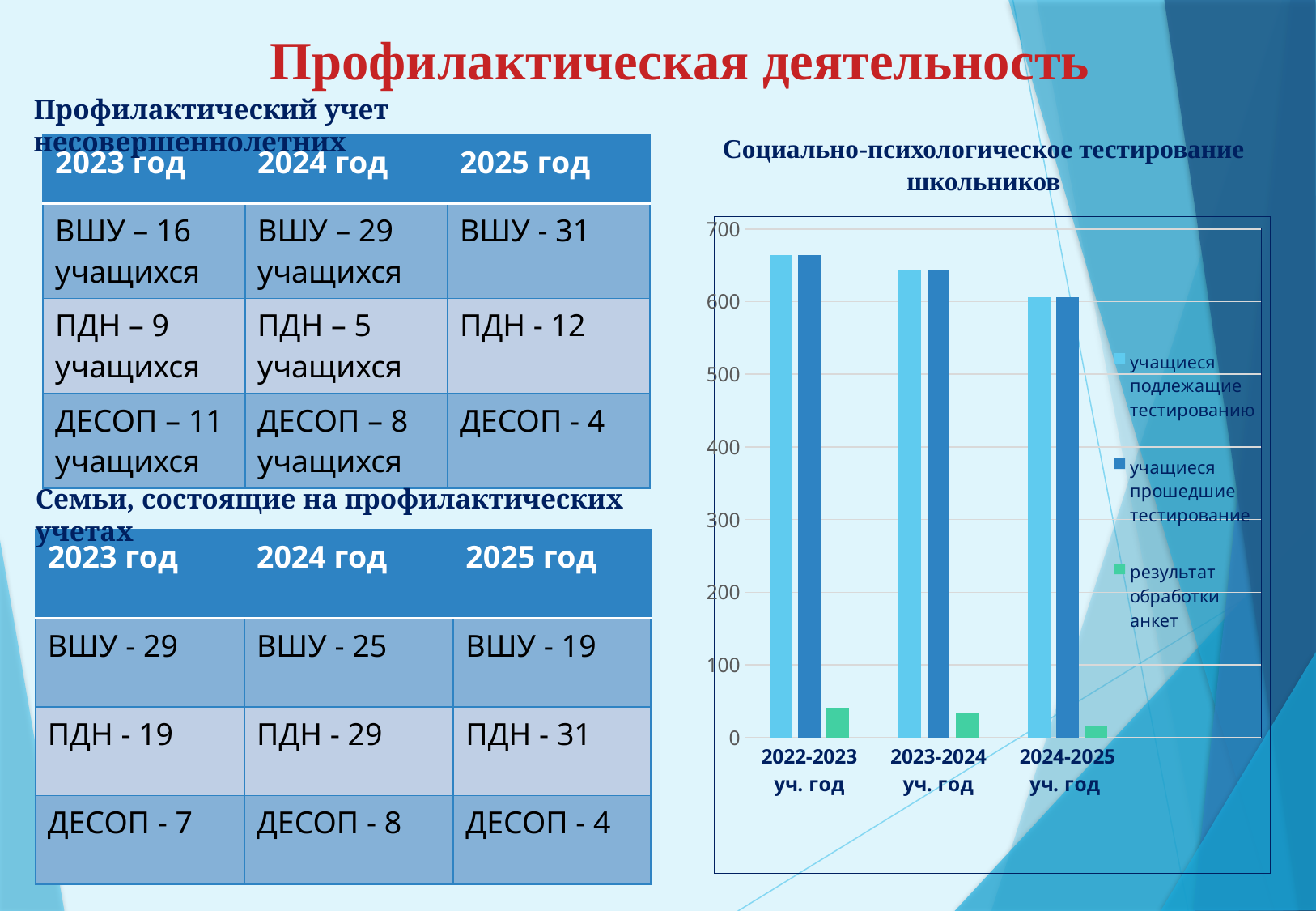
In which academic year is the value for 'учащиеся прошедшие тестирование' the lowest? 2024-2025 уч. год What is the title of the chart? Социально-психологическое тестирование школьников Do the values for 'учащиеся подлежащие тестированию' rise or fall from 2022-2023 to 2024-2025? fall How many series does the chart's legend list? 3 Which is larger: 'учащиеся подлежащие тестированию' in 2022-2023 уч. год or in 2024-2025 уч. год? 2022-2023 уч. год Is the value for 'результат обработки анкет' in 2024-2025 уч. год greater or less than 100? less Is the value for 'учащиеся подлежащие тестированию' in 2022-2023 уч. год greater or less than 600? greater How many academic years (categories) are shown on the x axis of the chart? 3 Which series is shown in green in the chart? результат обработки анкет In which academic year is the value for 'учащиеся подлежащие тестированию' the highest? 2022-2023 уч. год What kind of chart is shown on the slide? bar chart Is the value for 'учащиеся прошедшие тестирование' in 2023-2024 уч. год greater or less than 600? greater